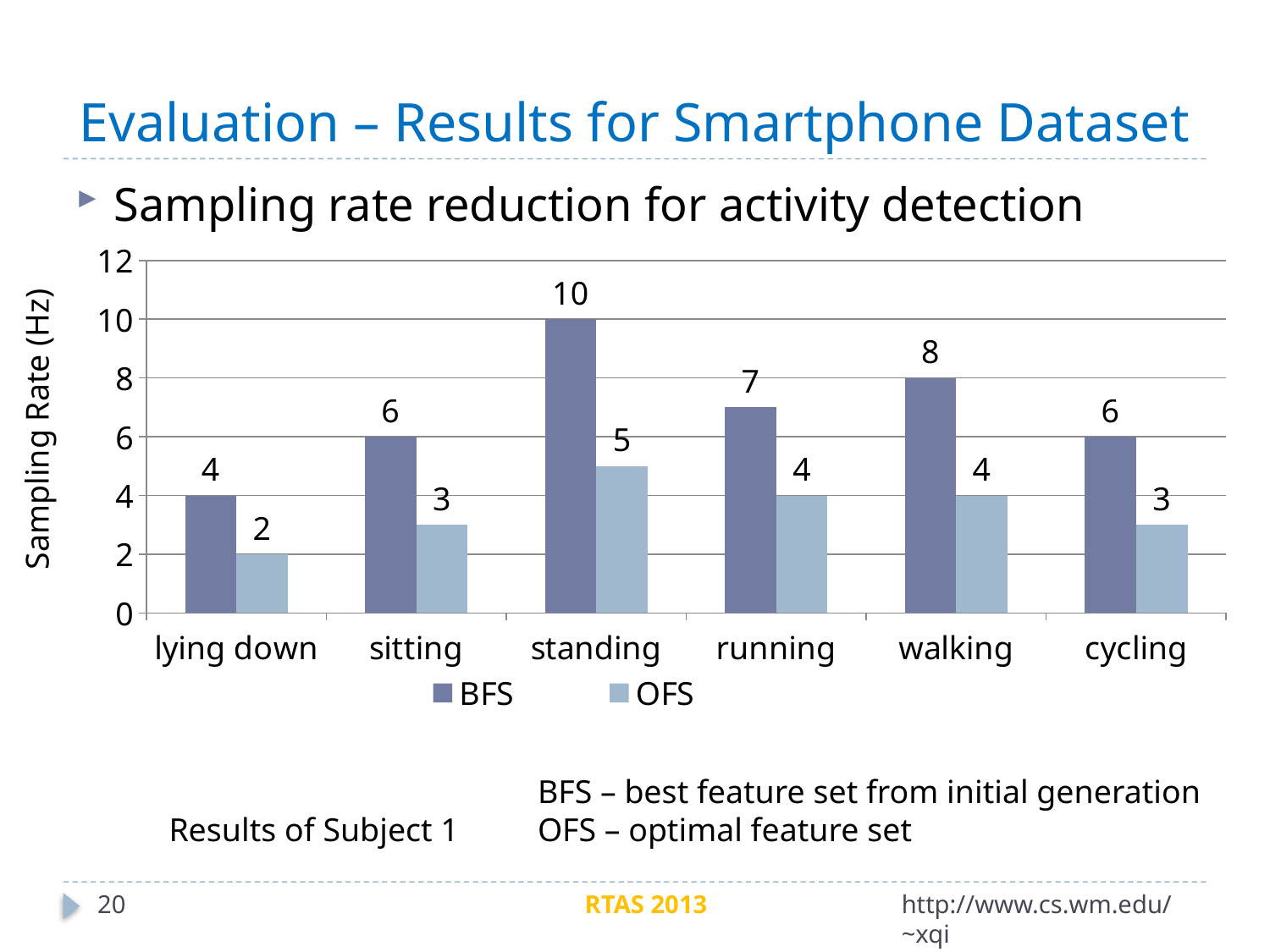
Which activity has the highest BFS sampling rate? standing What is the OFS sampling rate for lying down? 2 What is the OFS sampling rate for walking? 4 What is the BFS sampling rate for standing? 10 Which is larger, the BFS sampling rate for running or the BFS sampling rate for cycling? running What is the difference between the BFS and OFS sampling rates for standing? 5 What is the label of the y axis? Sampling Rate (Hz) What is the difference between the BFS sampling rates for walking and running? 1 How many activities are shown on the x axis? 6 How many series does the legend list? 2 Which activity has the lowest OFS sampling rate? lying down What kind of chart is shown on the slide? bar chart